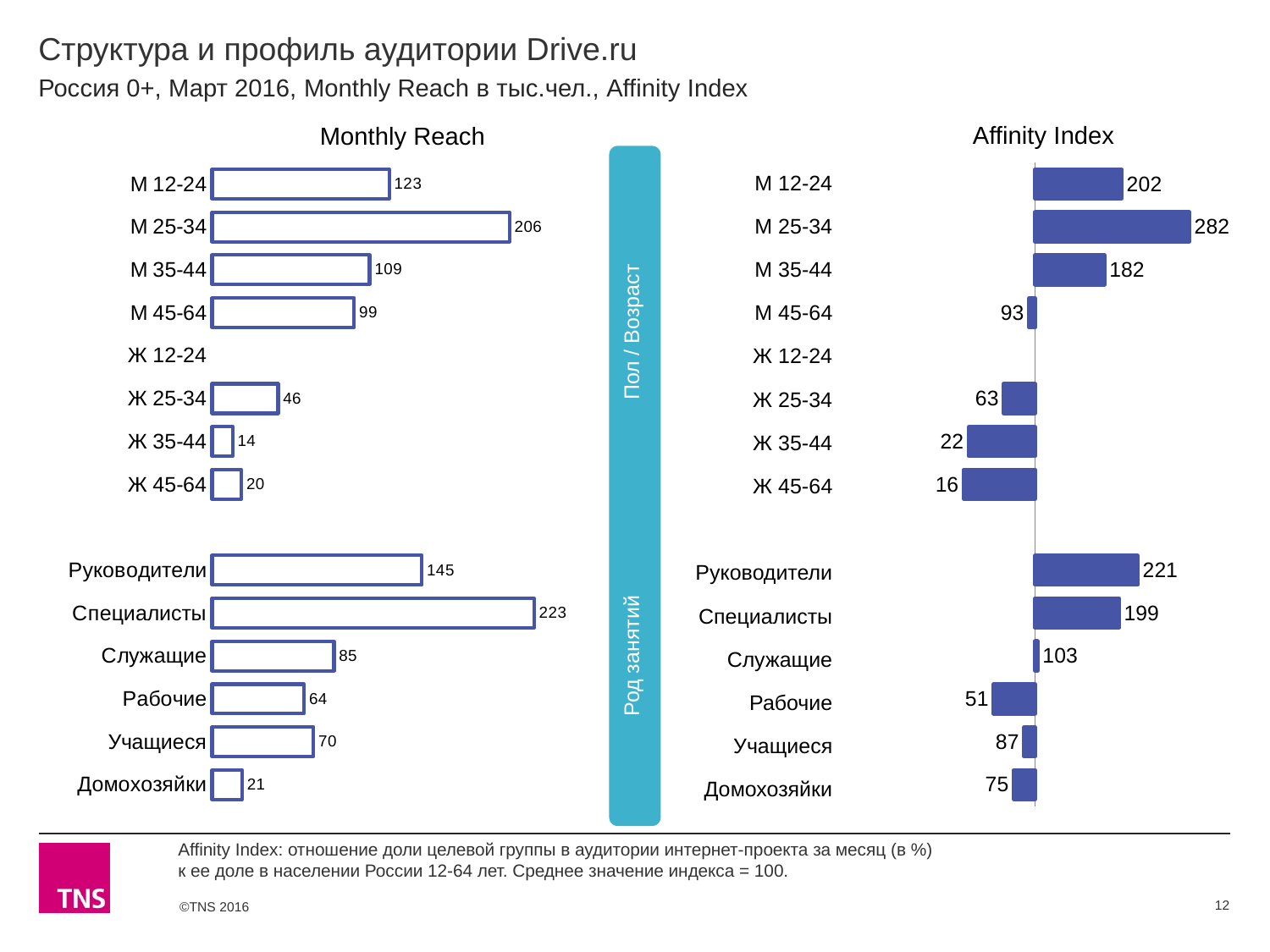
On the Monthly Reach chart, what is the difference between the values for Специалисты and Руководители? 78 On the Affinity Index chart, what is the value for Руководители? 221 On the Affinity Index chart, which gender/age category (Пол / Возраст) has the lowest value? Ж 45-64 On the Affinity Index chart, which gender/age category (Пол / Возраст) has the highest value? М 25-34 How many occupation categories (Род занятий) are listed on the Monthly Reach chart? 6 On the Monthly Reach chart, what is the value for Ж 35-44? 14 On the Affinity Index chart, what is the value for Служащие? 103 What kind of chart is the Affinity Index chart? Bar chart On the Monthly Reach chart, which occupation category (Род занятий) has the highest value? Специалисты On the Monthly Reach chart, what is the difference between the values for М 12-24 and М 45-64? 24 On the Affinity Index chart, which is larger: the value for М 12-24 or the value for М 35-44? М 12-24 On the Monthly Reach chart, what is the value for М 25-34? 206